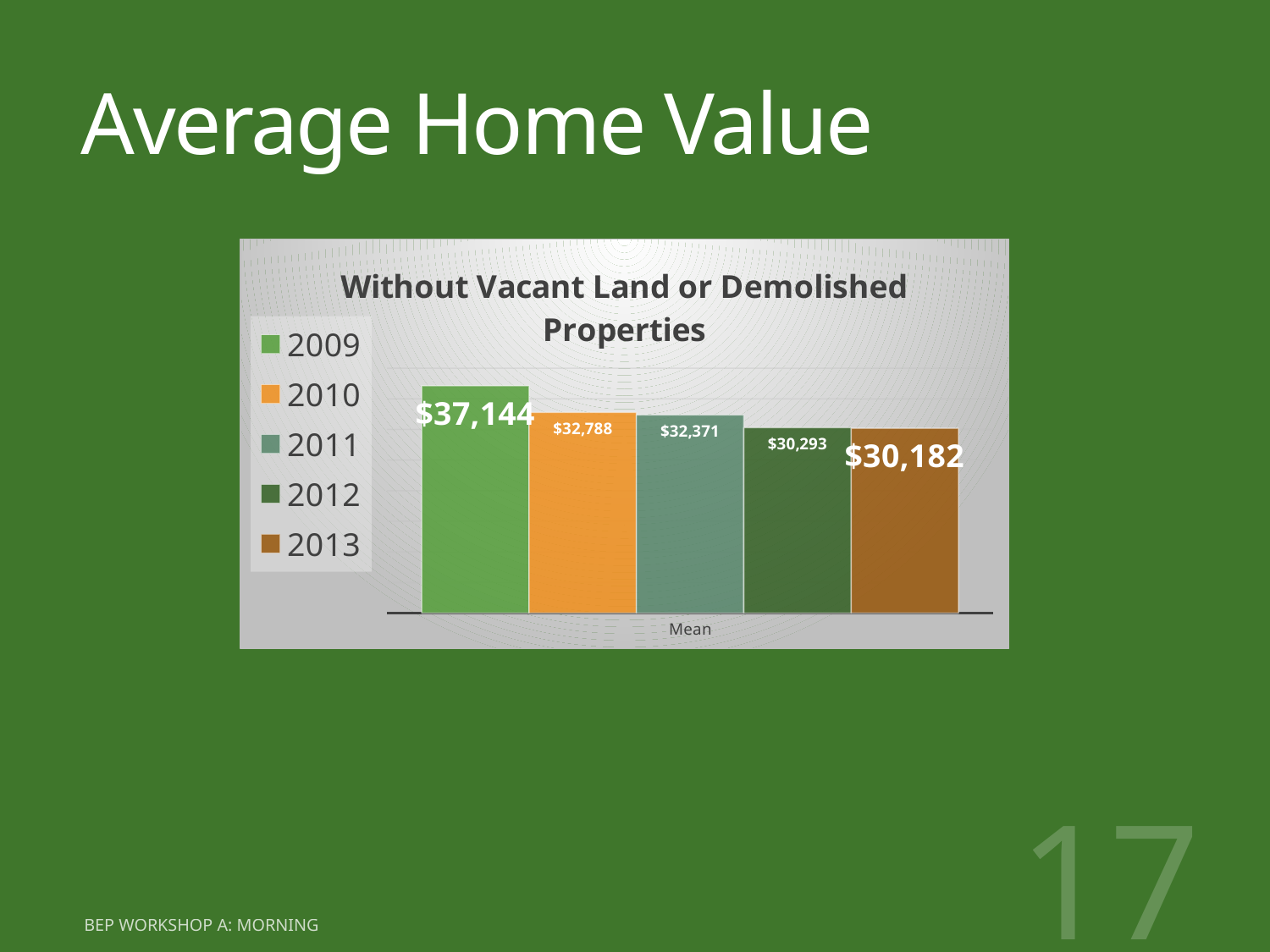
What is the value for 2009 in the chart? $37,144 How many series does the legend list? 5 Which is larger, the value for 2010 or the value for 2012? 2010 What is the value for 2012 in the chart? $30,293 What is the value for 2011 in the chart? $32,371 What is the difference between the 2009 value and the 2010 value? $4,356 What kind of chart is shown on the slide? Bar chart What is the difference between the 2012 value and the 2013 value? $111 Which year has the lowest average home value in the chart? 2013 What is the value for 2013 in the chart? $30,182 Which year has the highest average home value in the chart? 2009 What is the title of the chart? Without Vacant Land or Demolished Properties